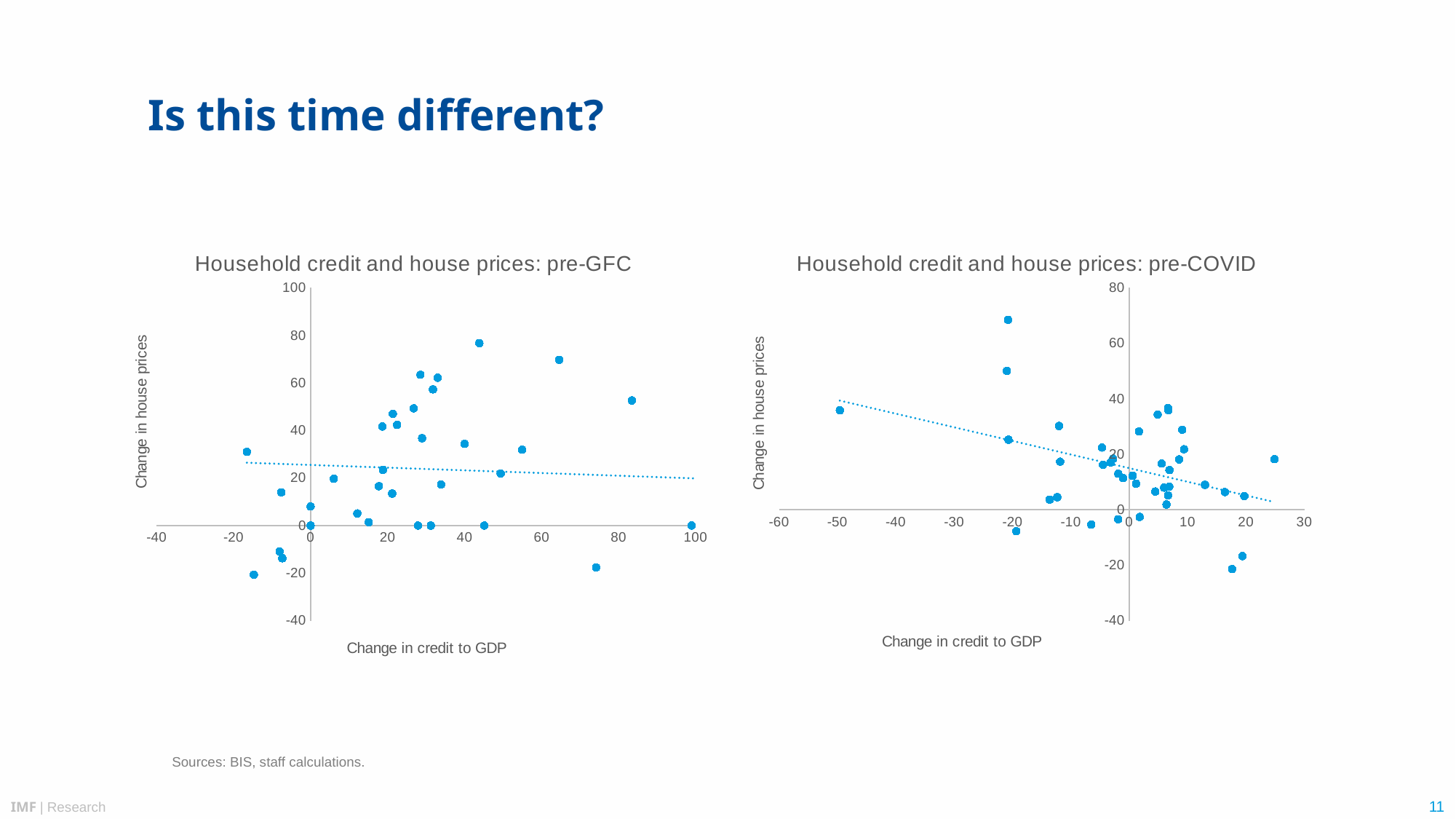
What is the x-axis label of the pre-GFC chart? Change in credit to GDP What kind of chart is the 'Household credit and house prices: pre-GFC' chart? scatter chart In the pre-COVID chart, is the change in house prices for the highest point greater or less than 60? greater What is the y-axis label of the pre-COVID chart? Change in house prices In the pre-GFC chart, is the change in house prices for the point at a change in credit to GDP of about 100 greater or less than 20? less In the pre-COVID chart, is the change in house prices for the point at a change in credit to GDP of about -50 greater or less than 20? greater In the pre-COVID chart, does the dotted trend line rise or fall as the change in credit to GDP increases? fall In the pre-COVID chart, is the highest point's change in house prices greater or less than the highest point's change in house prices in the pre-GFC chart? less What kind of chart is the 'Household credit and house prices: pre-COVID' chart? scatter chart In the pre-GFC chart, does the dotted trend line rise or fall as the change in credit to GDP increases? fall How many charts are shown on the slide? 2